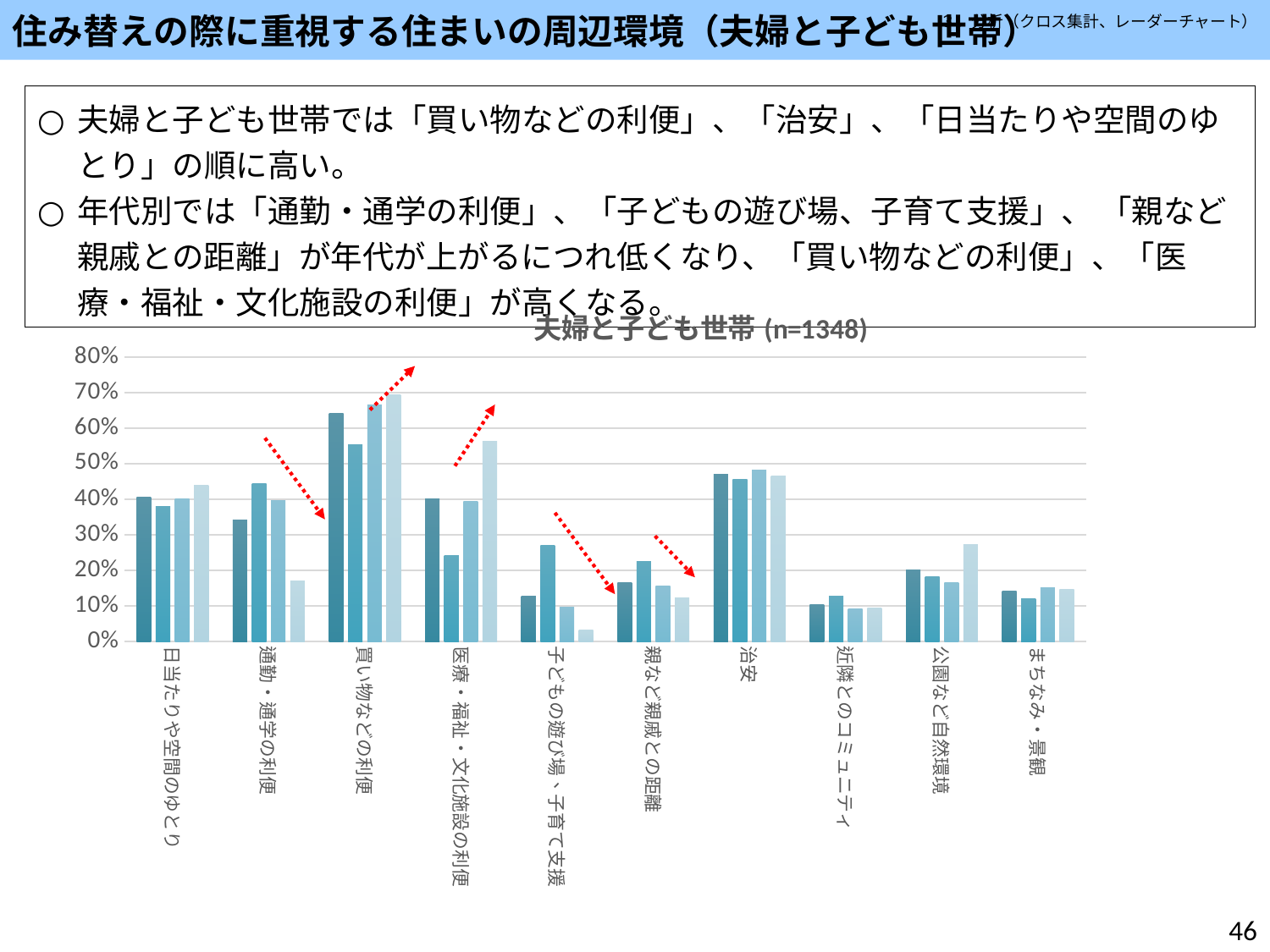
Which is larger: the first (darkest) bar for 治安 or the first (darkest) bar for 近隣とのコミュニティ? 治安 Is the value of the first (darkest) bar for 買い物などの利便 greater or less than 60%? greater Is the value of the first (darkest) bar for 近隣とのコミュニティ greater or less than 20%? less What is the title of the chart? 夫婦と子ども世帯 (n=1348) Which category has the tallest bars in the chart? 買い物などの利便 For 医療・福祉・文化施設の利便, which is larger: the second bar or the fourth (lightest) bar? the fourth (lightest) bar Is the value of the first (darkest) bar for 治安 greater or less than 40%? greater What sample size (n) is given in the chart title? 1348 What kind of chart is shown on the slide? bar chart How many categories are shown along the x axis of the chart? 10